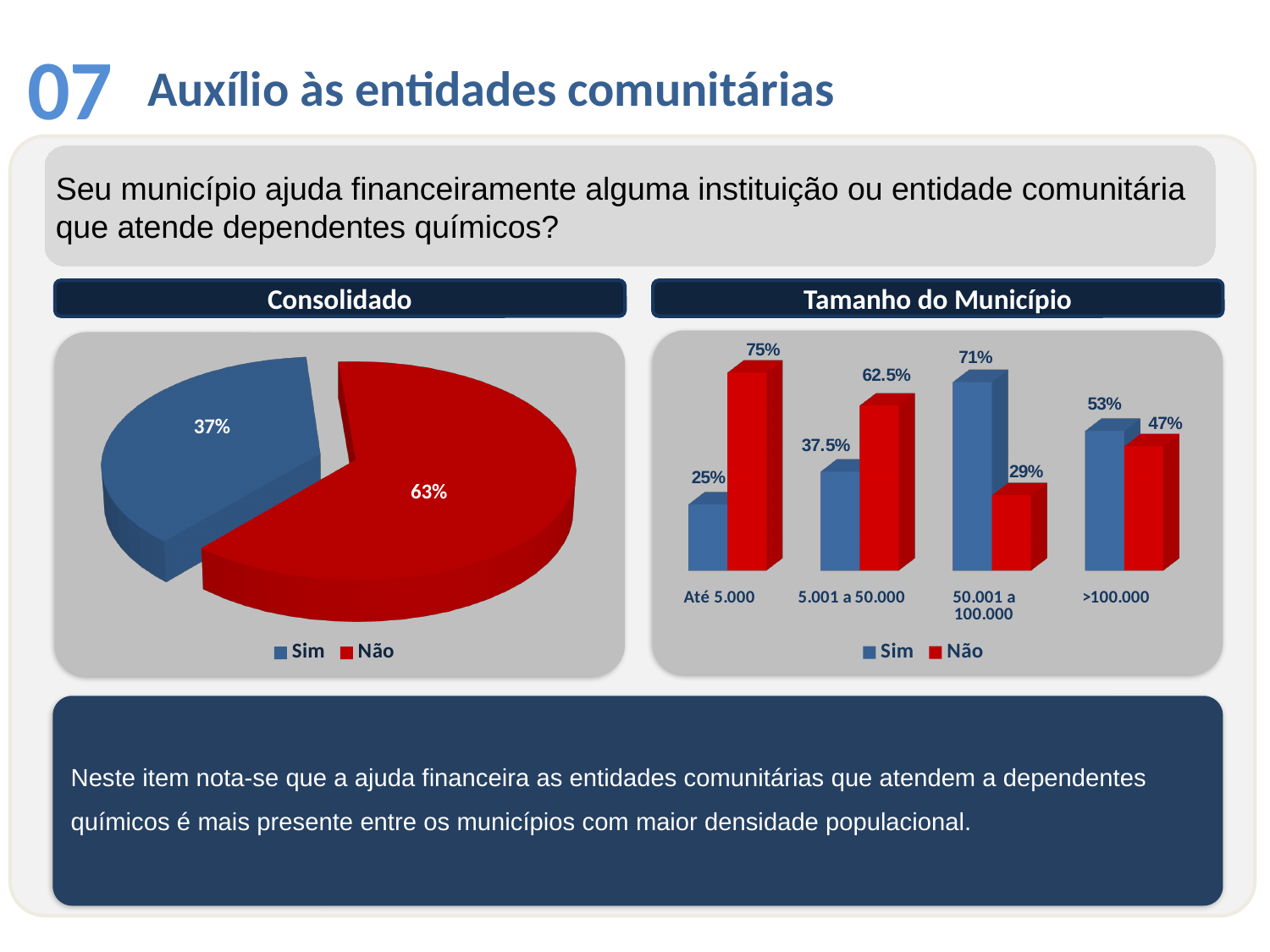
In the Tamanho do Município chart, what is the Sim value for 50.001 a 100.000? 71% In the Consolidado pie chart, what percentage answered Não? 63% In the Tamanho do Município chart, which municipality size has the highest Sim value? 50.001 a 100.000 What kind of chart is the Tamanho do Município chart? Bar chart In the Consolidado pie chart, what percentage answered Sim? 37% In the Tamanho do Município chart, what is the Não value for 5.001 a 50.000? 62.5% In the Consolidado pie chart, which slice is larger, Sim or Não? Não In the Tamanho do Município chart, what is the difference between the Não and Sim values for Até 5.000? 50% How many series does the legend of the Tamanho do Município chart list? 2 What kind of chart is the Consolidado chart? Pie chart In the Tamanho do Município chart, how many municipality size categories are shown? 4 In the Tamanho do Município chart, what is the Sim value for Até 5.000? 25%